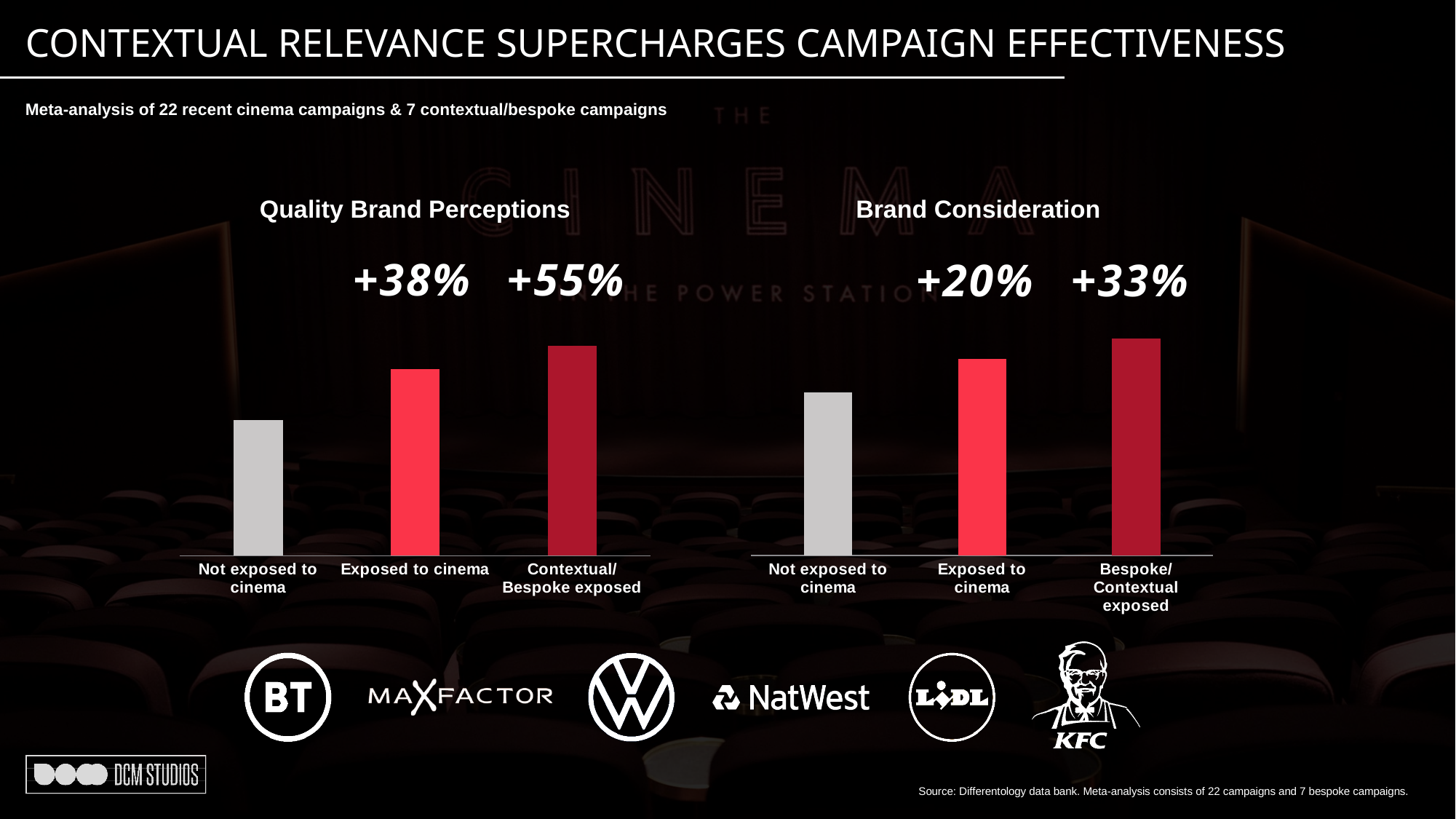
In the Quality Brand Perceptions chart, which category has the tallest bar? Contextual/Bespoke exposed In the Quality Brand Perceptions chart, what uplift is shown above the Exposed to cinema bar? +38% In the Quality Brand Perceptions chart, which bar is taller: Not exposed to cinema or Exposed to cinema? Exposed to cinema In the Quality Brand Perceptions chart, do the bars rise or fall from left to right? Rise In the Brand Consideration chart, which category has the shortest bar? Not exposed to cinema What type of chart is the Quality Brand Perceptions chart? Bar chart In the Brand Consideration chart, what uplift is shown above the Exposed to cinema bar? +20% What colour is the Not exposed to cinema bar in the Brand Consideration chart? Grey In the Brand Consideration chart, which bar is taller: Exposed to cinema or Bespoke/Contextual exposed? Bespoke/Contextual exposed In the Brand Consideration chart, what uplift is shown above the Bespoke/Contextual exposed bar? +33% How many bars are in the Brand Consideration chart? 3 In the Quality Brand Perceptions chart, what uplift is shown above the Contextual/Bespoke exposed bar? +55%